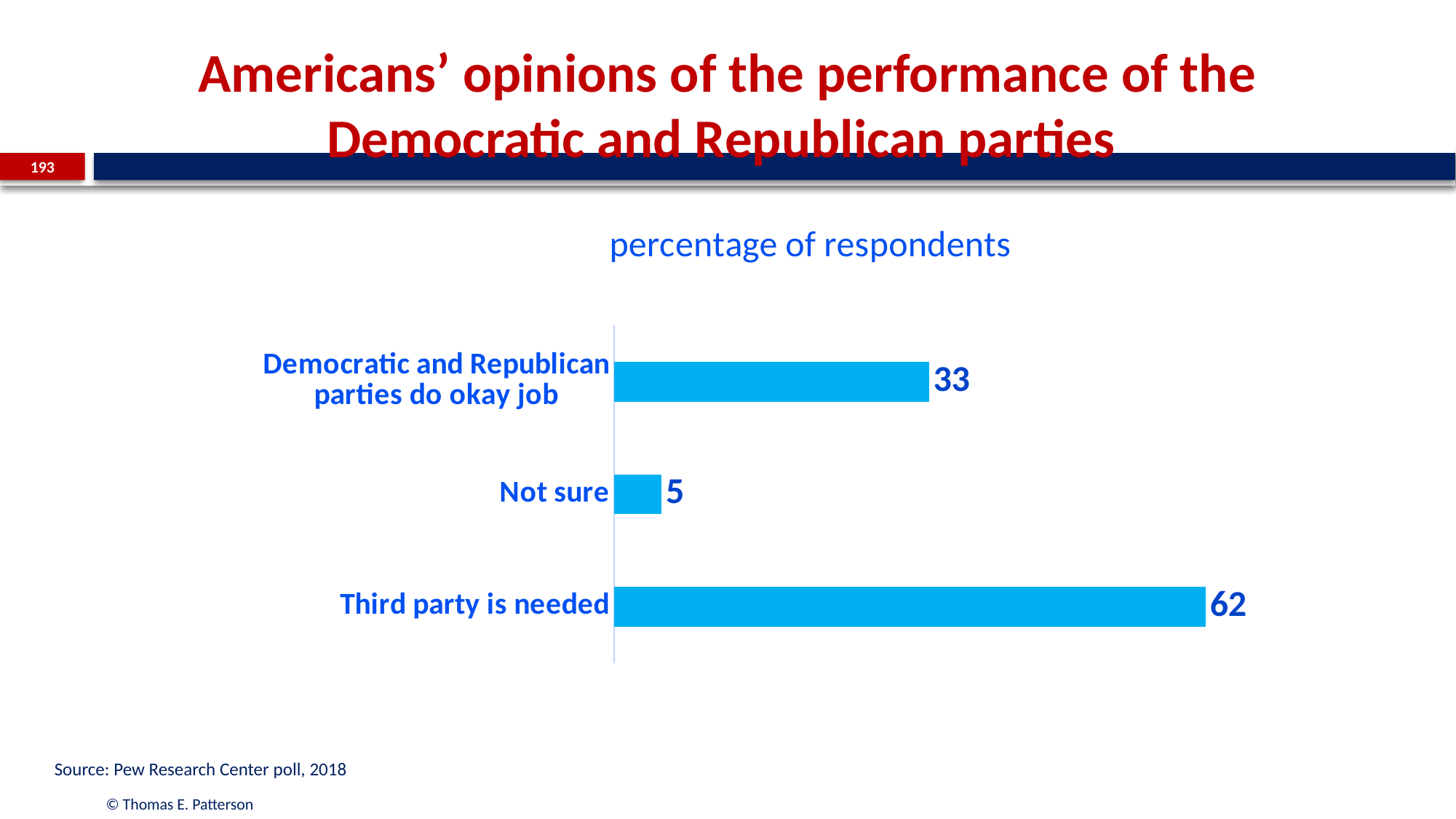
What kind of chart is shown on the slide? Bar chart How many categories are shown in the chart? 3 Which is larger: the percentage saying a third party is needed or the percentage saying the parties do an okay job? Third party is needed Which category has the lowest percentage of respondents? Not sure Which category has the highest percentage of respondents? Third party is needed What is the total of the three percentages shown in the chart? 100 What percentage of respondents said the Democratic and Republican parties do an okay job? 33 What percentage of respondents were not sure? 5 What is the difference between the percentage saying a third party is needed and the percentage saying the parties do an okay job? 29 What is the difference between the percentage saying the parties do an okay job and the percentage not sure? 28 What is the source of the data shown in the chart? Pew Research Center poll, 2018 What percentage of respondents said a third party is needed? 62